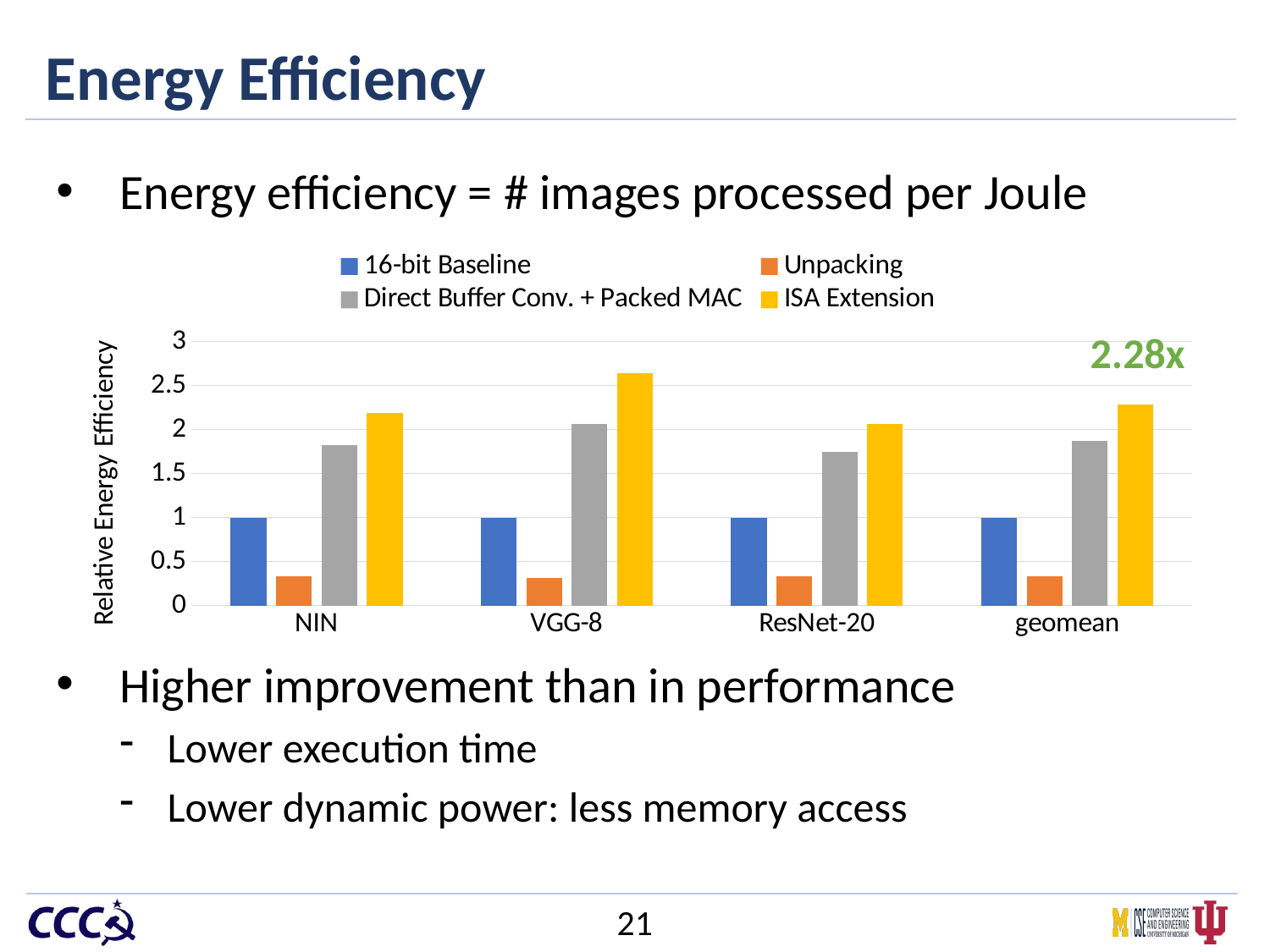
Which is larger for NIN: the Direct Buffer Conv. + Packed MAC bar or the ISA Extension bar? ISA Extension What is the label of the y axis of the chart? Relative Energy Efficiency Is the Unpacking value for NIN greater or less than 0.5? less Which is larger: the ISA Extension value for NIN or for VGG-8? VGG-8 What relative energy efficiency value is annotated for the ISA Extension at geomean? 2.28x Is the ISA Extension value for VGG-8 greater or less than 2.5? greater What kind of chart is shown on the slide? bar chart What is the relative energy efficiency of the 16-bit Baseline for NIN? 1 Is the Direct Buffer Conv. + Packed MAC value for ResNet-20 greater or less than 1.5? greater How many series does the chart legend list? 4 Which category has the highest ISA Extension bar? VGG-8 How many categories are shown on the x axis of the chart? 4